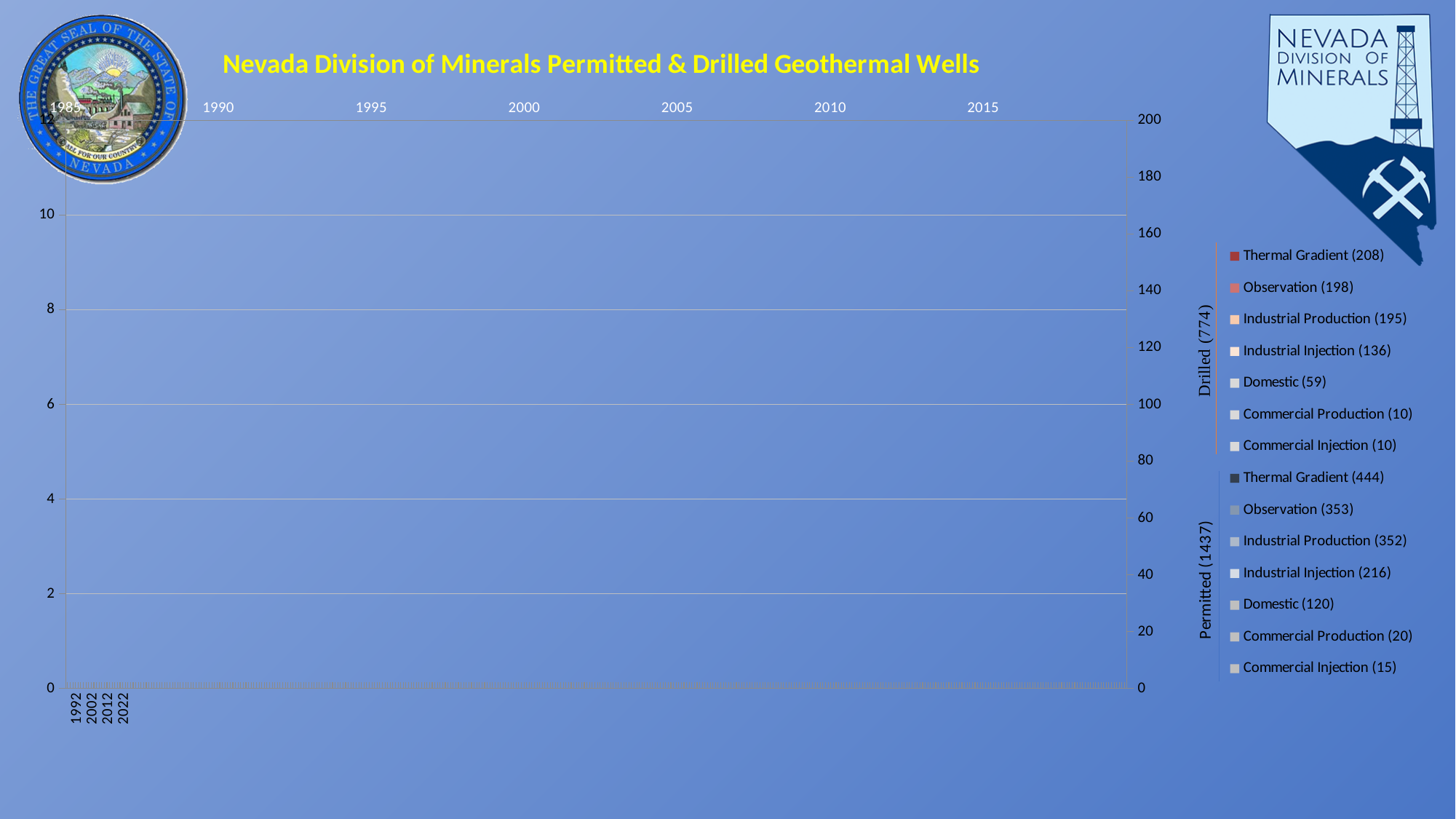
What is the difference between permitted and drilled Observation wells according to the legend? 155 According to the legend, how many Industrial Injection wells were drilled? 136 Which legend category has the lowest permitted count? Commercial Injection (15) According to the legend, how many Thermal Gradient wells were drilled? 208 According to the legend, how many Thermal Gradient wells were permitted? 444 What is the title of the chart? Nevada Division of Minerals Permitted & Drilled Geothermal Wells What total is shown in the right-hand axis label for Permitted wells? 1437 Which legend category has the highest drilled count? Thermal Gradient (208) What is the maximum value shown on the right-hand vertical axis? 200 According to the legend, how many Domestic wells were permitted? 120 How many series does the legend list in total? 14 What total is shown in the right-hand axis label for Drilled wells? 774